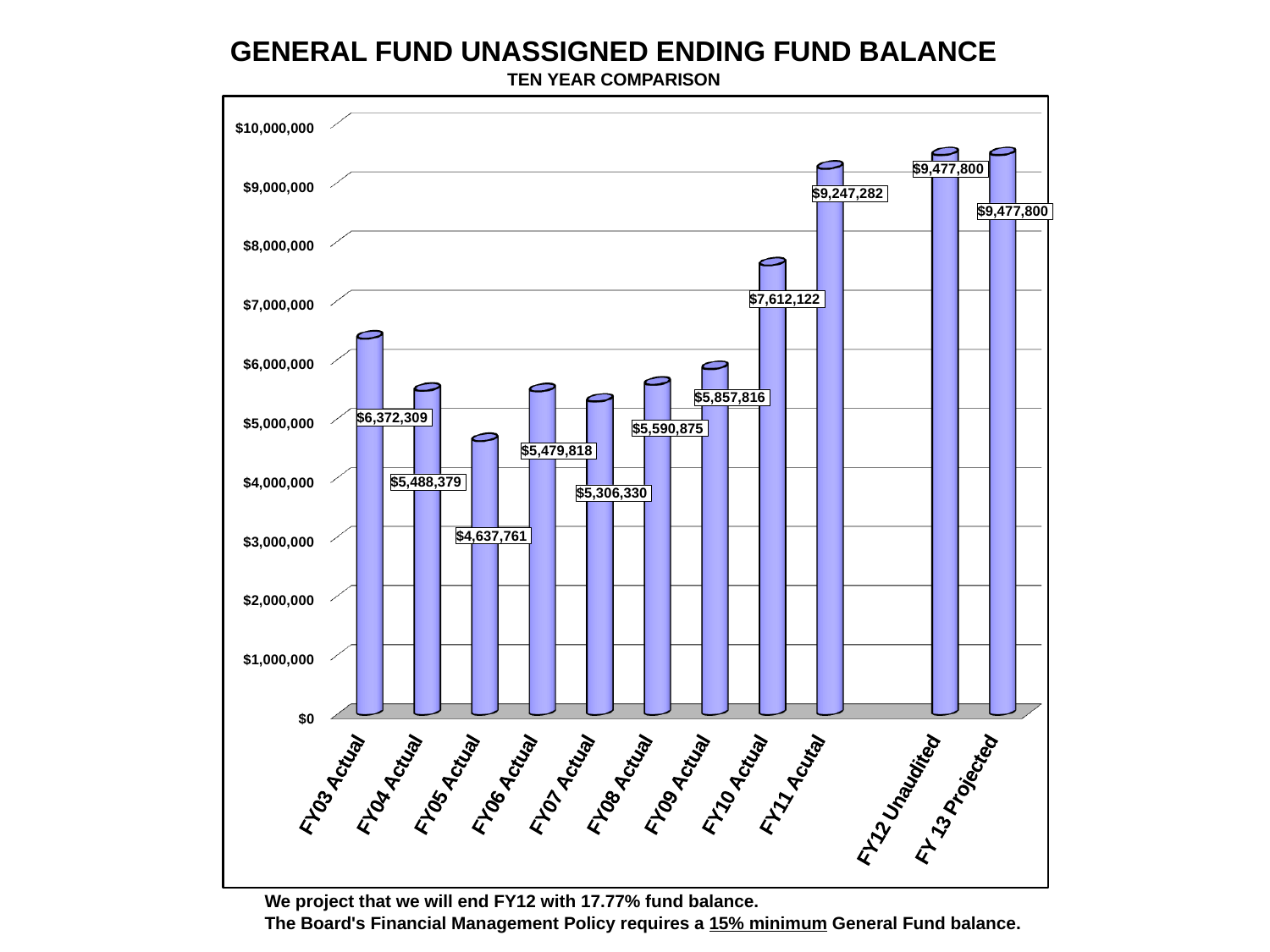
How many fiscal years are shown on the x axis? 11 What is the value for FY05 Actual? $4,637,761 What is the difference between the FY11 Acutal value and the FY10 Actual value? $1,635,160 What is the subtitle of the chart? TEN YEAR COMPARISON What is the value for FY 13 Projected? $9,477,800 Which is larger, the value for FY03 Actual or the value for FY04 Actual? FY03 Actual What kind of chart is this? bar chart What is the difference between the FY03 Actual value and the FY05 Actual value? $1,734,548 Which fiscal year has the lowest unassigned ending fund balance? FY05 Actual Do the values rise or fall from FY05 Actual to FY12 Unaudited? rise Is the value for FY10 Actual greater or less than $7,000,000? greater What is the value for FY10 Actual? $7,612,122